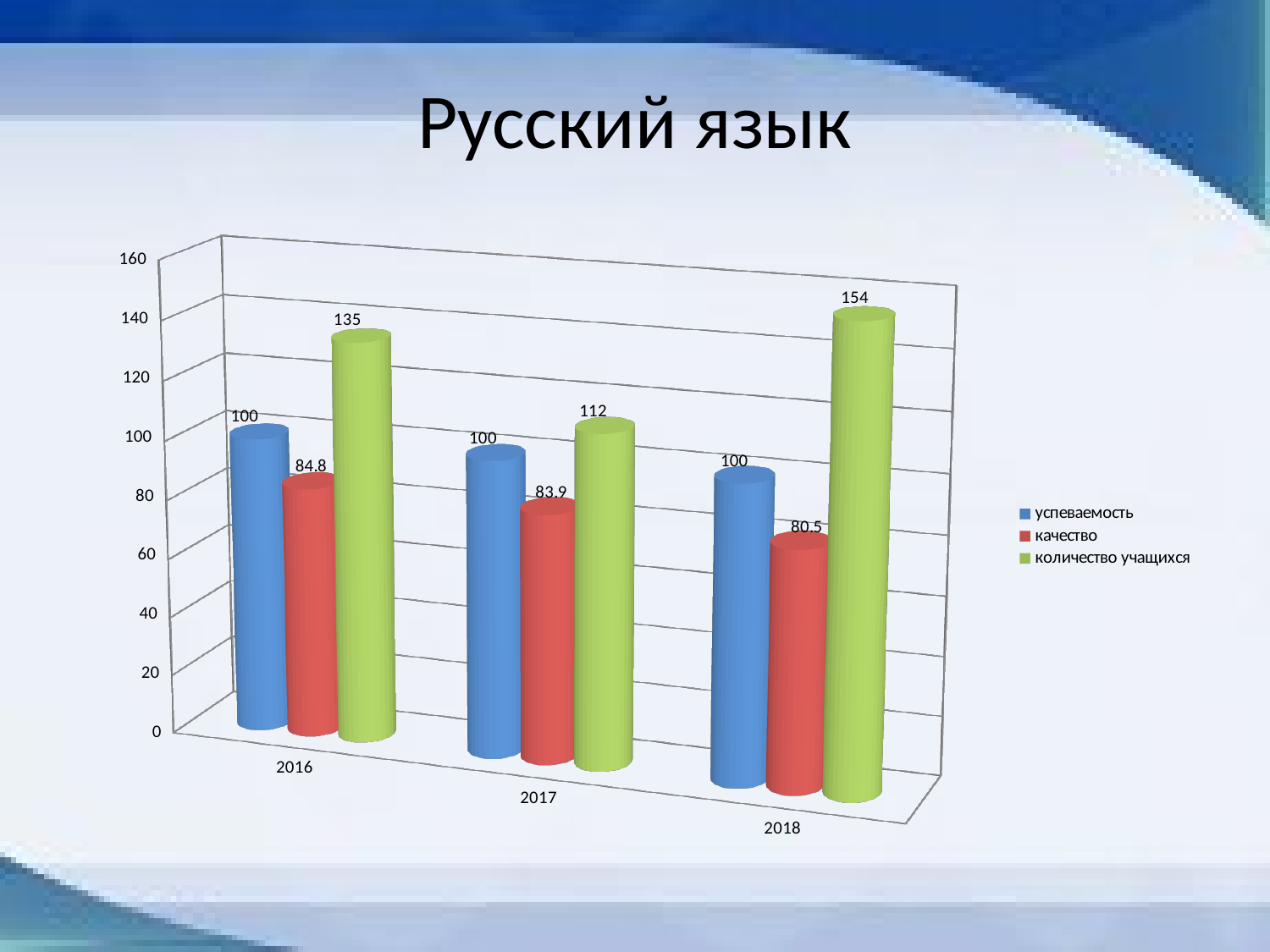
What is the value of количество учащихся for 2017? 112 What is the value of успеваемость for 2017? 100 In which year is количество учащихся highest? 2018 Does качество rise or fall from 2016 to 2018? fall How many years are shown on the x axis? 3 What is the difference between количество учащихся in 2018 and in 2016? 19 In which year is качество lowest? 2018 What is the value of количество учащихся for 2018? 154 What kind of chart is shown on the slide? bar chart How many series does the legend list? 3 What is the value of качество for 2016? 84.8 Which is larger: качество in 2016 or качество in 2018? качество in 2016